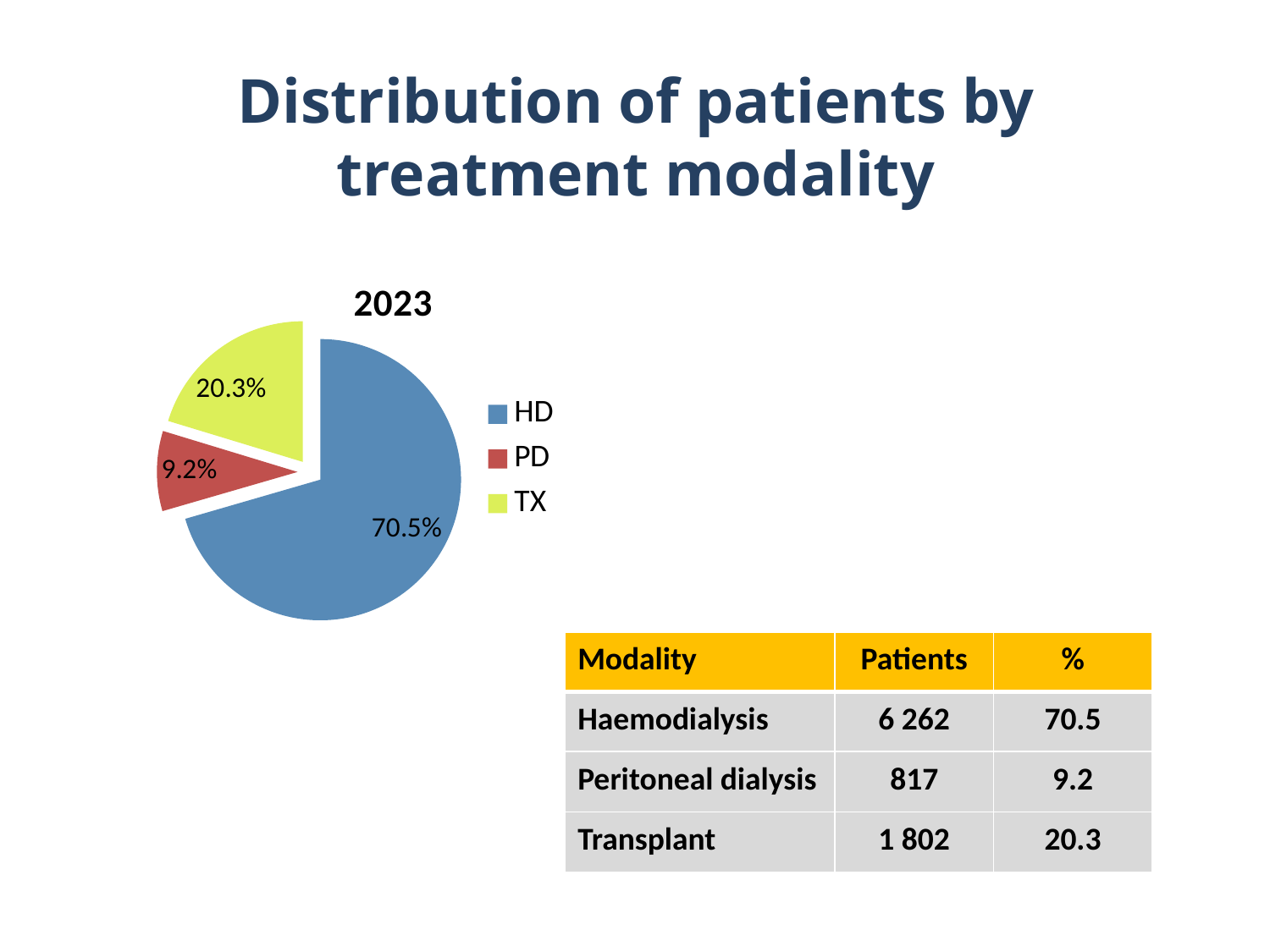
What colour is the TX slice in the pie chart? yellow-green What share of the pie does HD have? 70.5% Which slice of the pie is the smallest? PD What kind of chart is shown on the slide? pie chart What share of the pie does TX have? 20.3% What share of the pie does PD have? 9.2% Which is larger, the TX slice or the PD slice? TX What is the chart's title? 2023 What is the difference in percentage points between the HD slice and the TX slice? 50.2 How many slices does the pie chart have? 3 How many entries does the legend list? 3 Which slice of the pie is the largest? HD